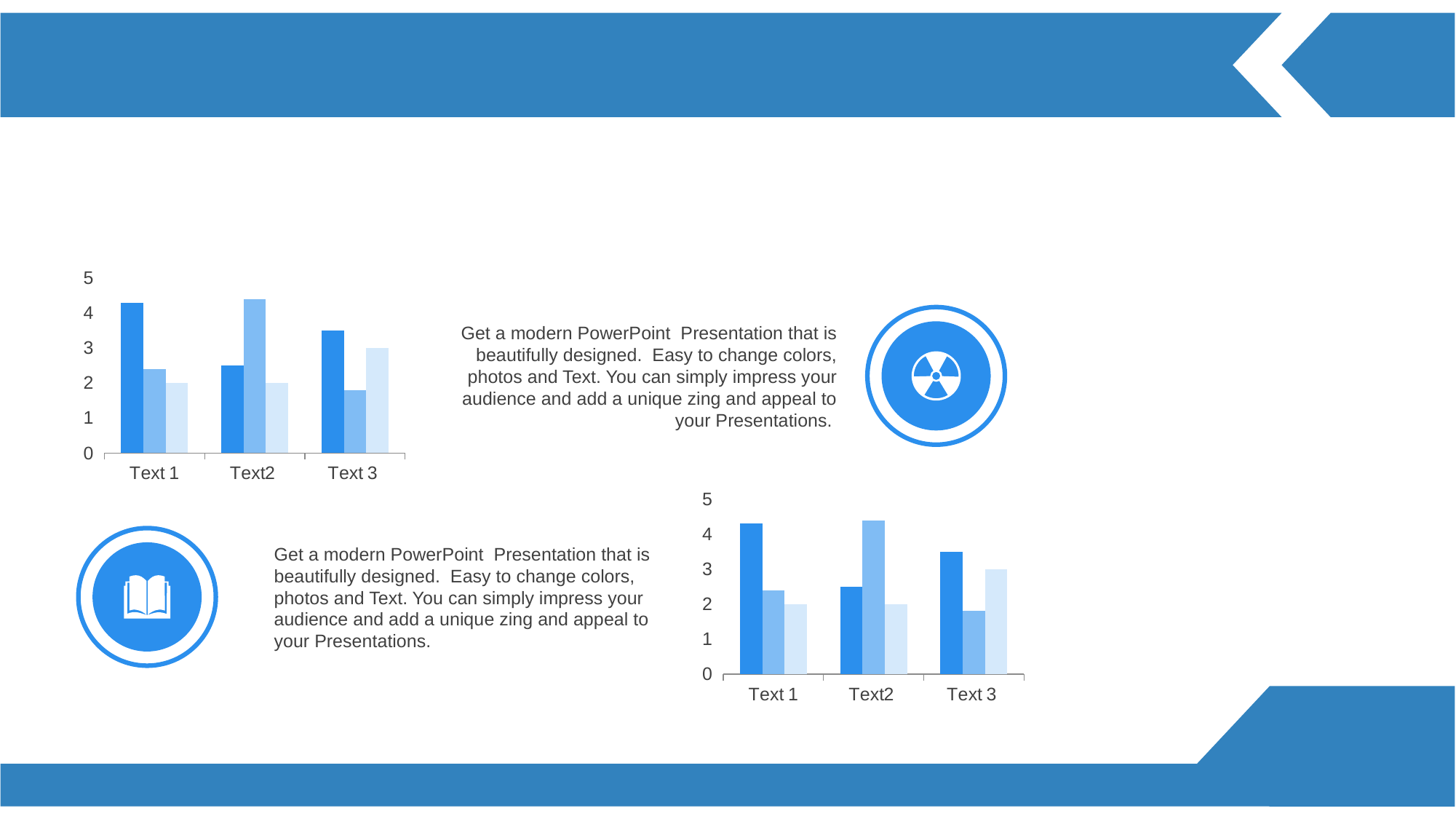
What are the category labels on the x axis of the bottom-right chart? Text 1, Text2, Text 3 In the top-left chart, is the dark blue bar for Text2 greater or less than 3? less How many bars are drawn for each category in the bottom-right chart? 3 In the top-left chart, which is taller: the dark blue bar for Text 1 or the dark blue bar for Text 3? Text 1 In the bottom-right chart, is the medium blue bar for Text 3 greater or less than 2? less In the top-left chart, which category has the tallest dark blue bar? Text 1 In the top-left chart, what value does the light blue bar for Text 3 reach on the axis? 3 In the bottom-right chart, is the medium blue bar for Text2 greater or less than 4? greater In the bottom-right chart, which category has the shortest medium blue bar? Text 3 How many categories are shown on the x axis of the top-left chart? 3 What kind of chart is the top-left chart on the slide? bar chart